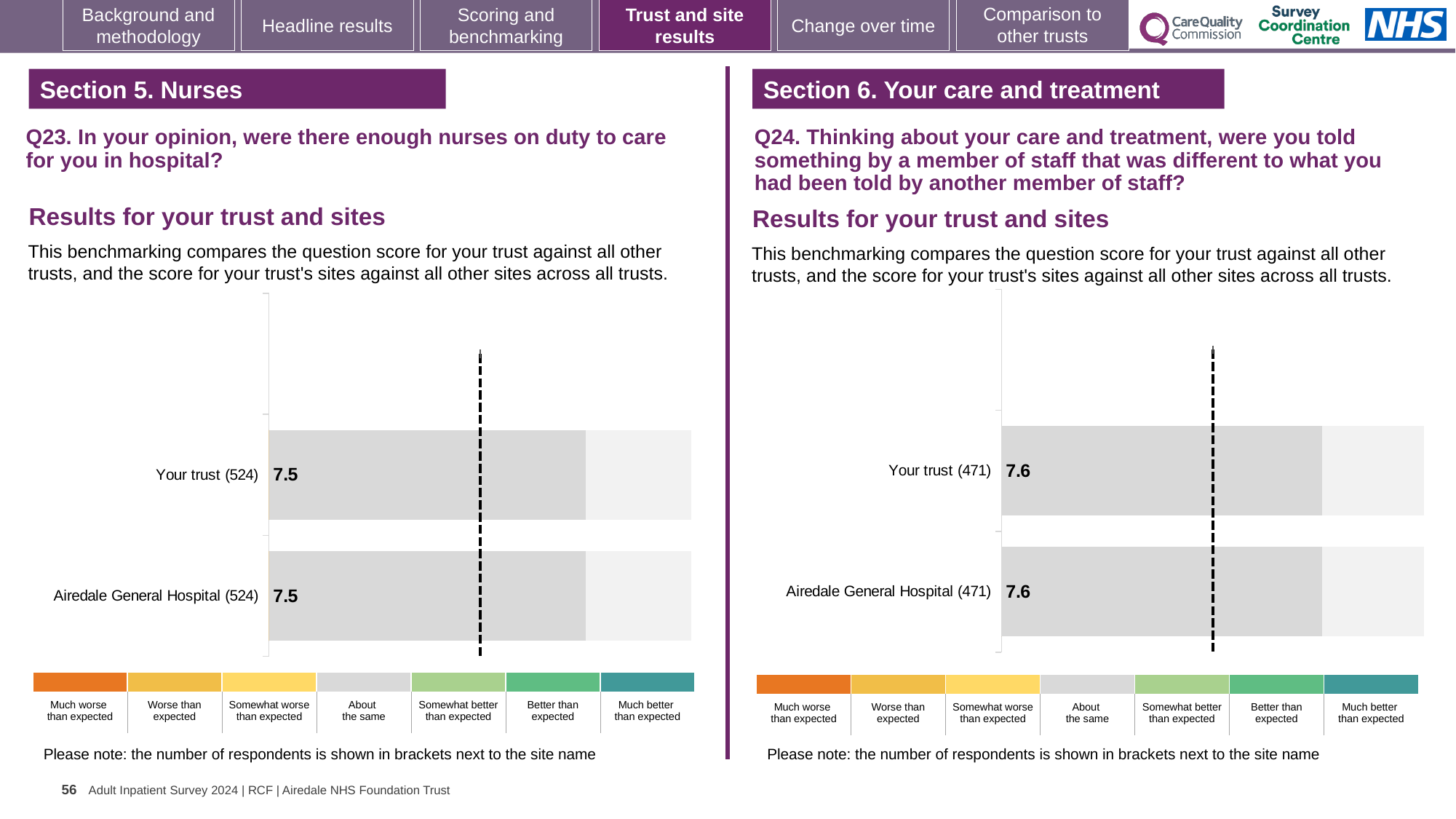
On the Q24 chart (right), what is the score for Your trust? 7.6 How many bars are plotted on the Q24 chart (right)? 2 On the Q23 chart (left), what is the difference between the score for Your trust and the score for Airedale General Hospital? 0 On the Q23 chart (left), what is the score for Airedale General Hospital? 7.5 Is the score for Your trust on the Q24 chart (right) higher or lower than the score for Your trust on the Q23 chart (left)? Higher On the Q24 chart (right), how many respondents are shown in brackets for Airedale General Hospital? 471 On the Q24 chart (right), what is the score for Airedale General Hospital? 7.6 On the Q24 chart (right), what is the difference between the score for Your trust and the score for Airedale General Hospital? 0 On the Q23 chart (left), what is the score for Your trust? 7.5 How many bars are plotted on the Q23 chart (left)? 2 On the Q23 chart (left), how many respondents are shown in brackets for Your trust? 524 What kind of chart is used for the Q23 results (left)? Bar chart